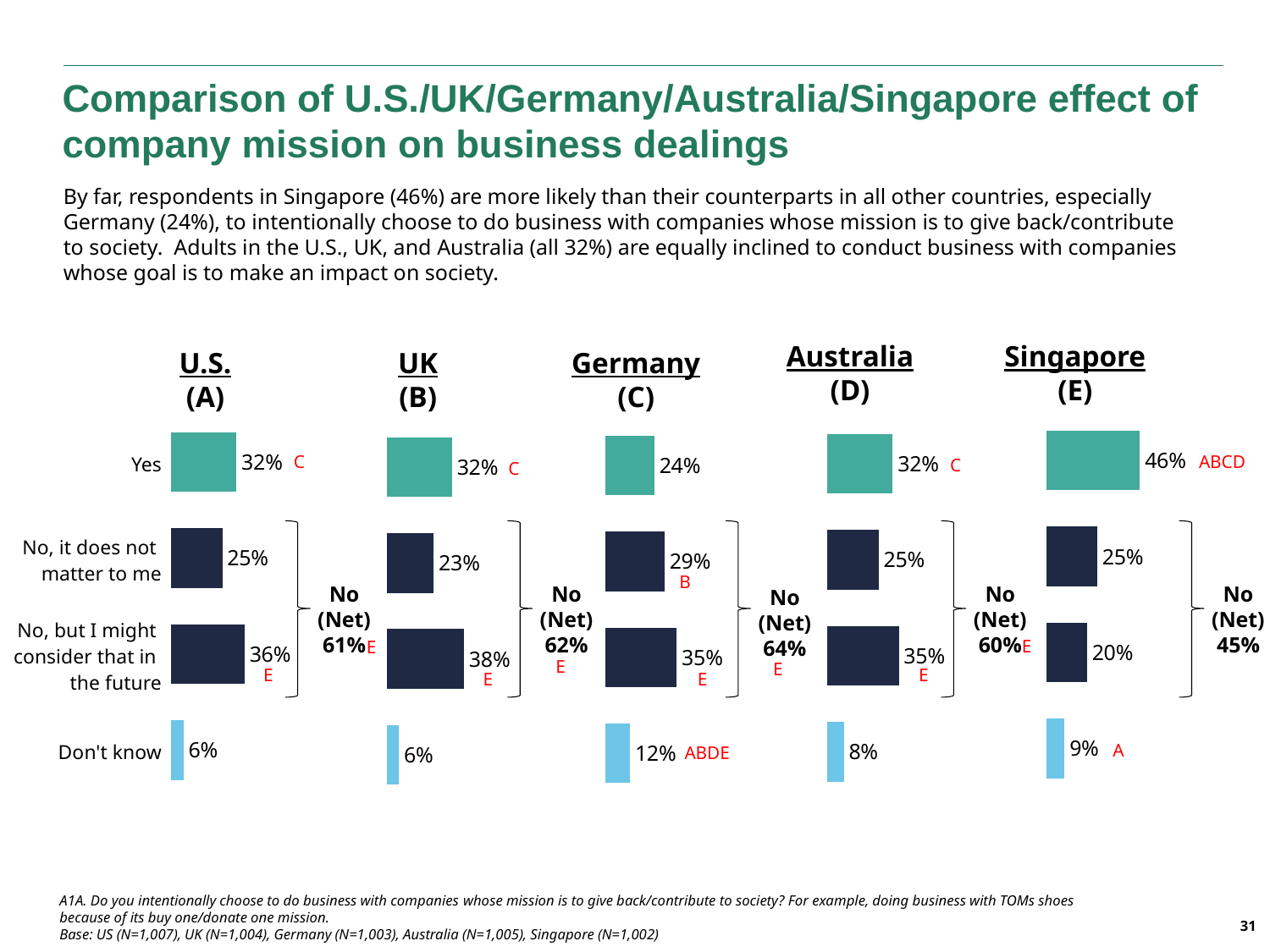
In the Germany (C) chart, what percentage of respondents answered Don't know? 12% Across the five country charts, which country has the lowest Yes percentage? Germany In the Australia (D) chart, what is the No (Net) value? 64% In the UK (B) chart, what percentage of respondents answered 'No, but I might consider that in the future'? 38% Across the five country charts, which country has the highest Yes percentage? Singapore In the Singapore (E) chart, what is the difference between the 'No, it does not matter to me' value and the 'No, but I might consider that in the future' value? 5% How many response categories are shown in each country chart? 4 In the Germany (C) chart, what percentage of respondents answered 'No, it does not matter to me'? 29% In the U.S. (A) chart, which is larger: 'No, it does not matter to me' or 'No, but I might consider that in the future'? No, but I might consider that in the future What is the difference between the Yes percentage for Singapore (E) and the Yes percentage for Germany (C)? 22% What type of chart is used to show the responses for each country? Bar chart In the Singapore (E) chart, what percentage of respondents answered Yes? 46%